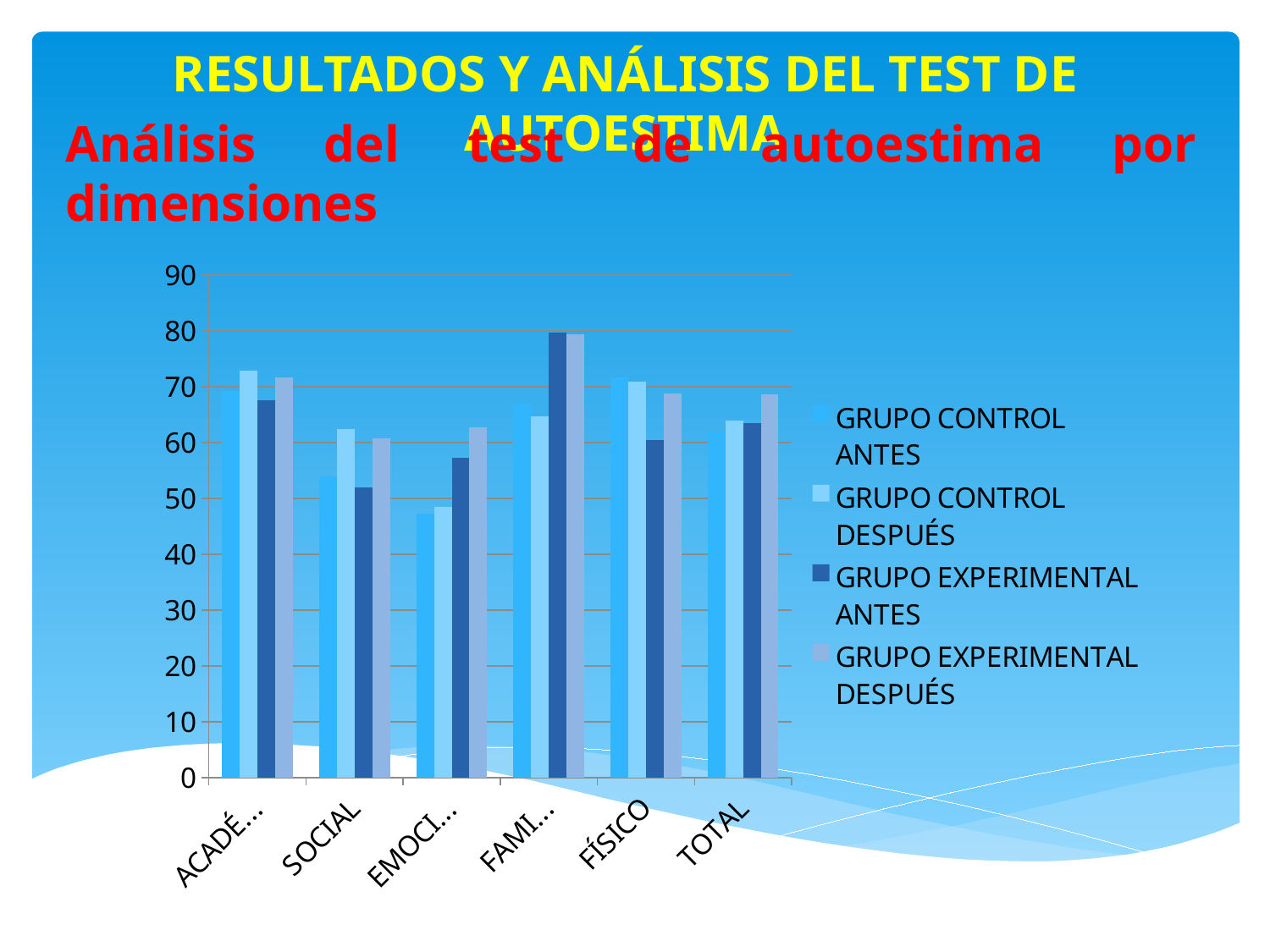
What is the last entry listed in the chart's legend? GRUPO EXPERIMENTAL DESPUÉS Is the value for GRUPO EXPERIMENTAL ANTES in the SOCIAL category greater or less than 60? less What kind of chart is shown on the slide? bar chart In the EMOCI... category, which is larger: GRUPO CONTROL ANTES or GRUPO EXPERIMENTAL DESPUÉS? GRUPO EXPERIMENTAL DESPUÉS In the FÍSICO category, which is larger: GRUPO CONTROL ANTES or GRUPO EXPERIMENTAL ANTES? GRUPO CONTROL ANTES Is the value for GRUPO EXPERIMENTAL ANTES in the FAMI... category greater or less than 70? greater Is the value for GRUPO CONTROL DESPUÉS in the FÍSICO category greater or less than 60? greater For the GRUPO EXPERIMENTAL ANTES series, which category has the highest value? FAMI... How many series does the chart's legend list? 4 For the GRUPO CONTROL ANTES series, which category has the lowest value? EMOCI... How many categories are shown along the x axis of the chart? 6